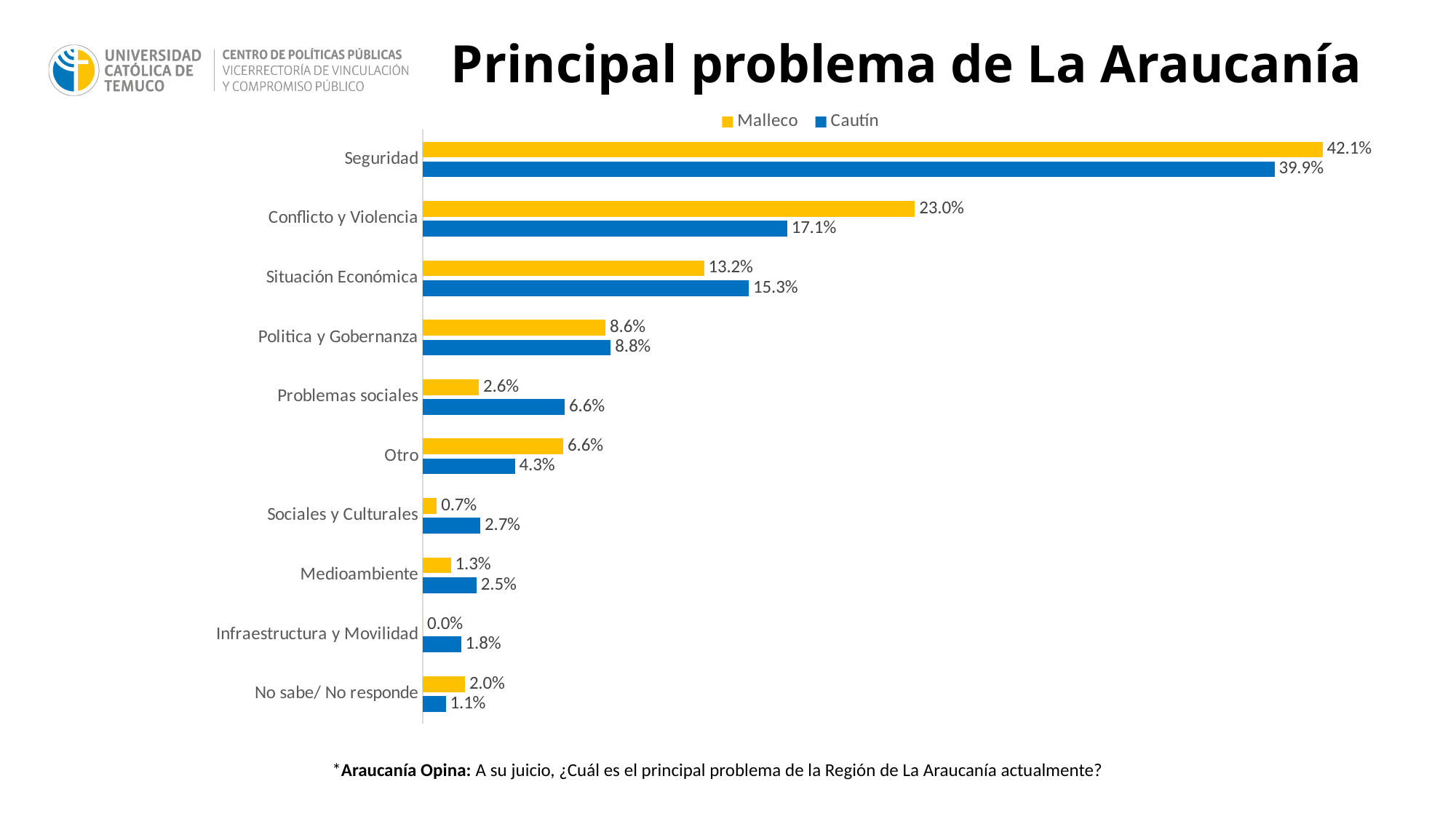
What is the difference between the Malleco and Cautín values for Seguridad? 2.2% Which category has the lowest Malleco value? Infraestructura y Movilidad What is the difference between the Cautín and Malleco values for Problemas sociales? 4.0% What kind of chart is shown on the slide? Bar chart What is the Malleco value for Seguridad? 42.1% What is the Malleco value for Infraestructura y Movilidad? 0.0% How many categories are shown on the chart? 10 Which category has the highest Cautín value? Seguridad How many series does the legend list? 2 Which is larger for Situación Económica, the Malleco value or the Cautín value? Cautín Which colour represents the Malleco series? Yellow What is the Cautín value for Conflicto y Violencia? 17.1%